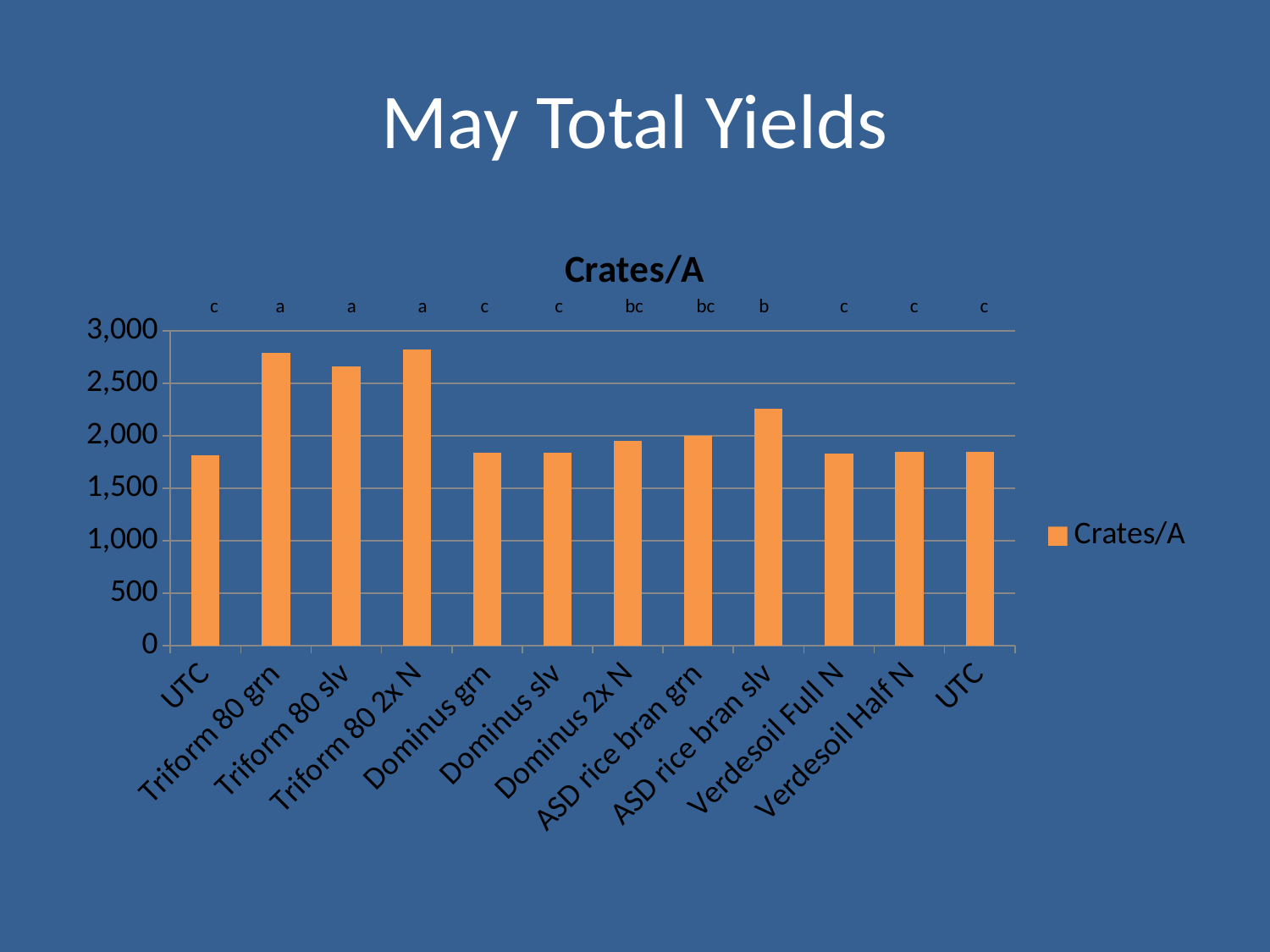
Is the value for ASD rice bran slv greater or less than 2,000? greater Which is larger, the value for ASD rice bran slv or the value for ASD rice bran grn? ASD rice bran slv How many series does the legend list? 1 Which is larger, the value for Triform 80 grn or the value for Triform 80 slv? Triform 80 grn Is the value for Triform 80 grn greater or less than 2,500? greater What kind of chart is shown on the slide? bar chart What letter is printed above the bar for ASD rice bran slv? b How many bars are plotted in the chart? 12 Is the value for Verdesoil Full N greater or less than 2,000? less What is the title shown above the chart? Crates/A